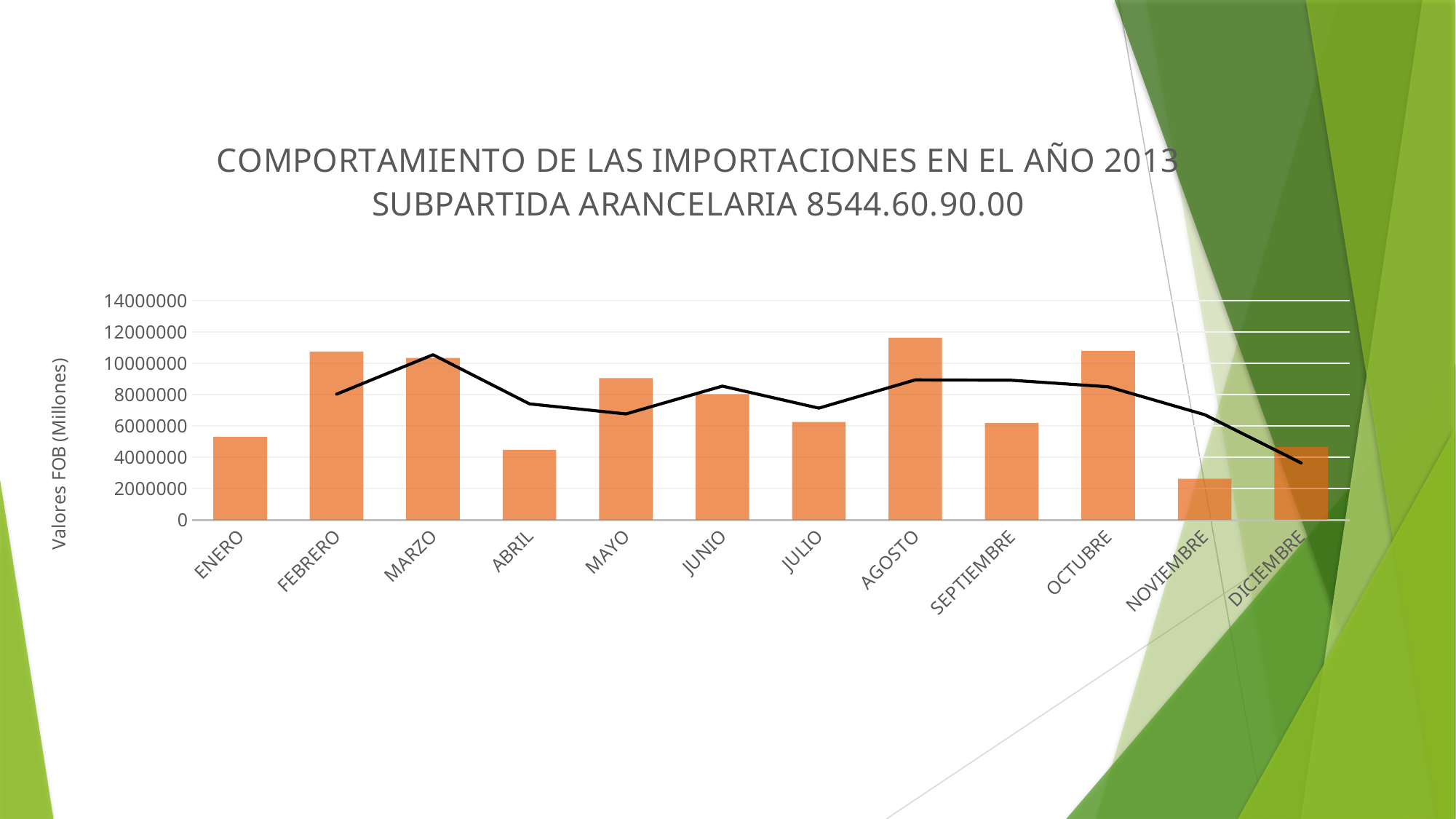
Is the value for MAYO greater or less than 8000000? greater Is the value for NOVIEMBRE greater or less than 4000000? less How many months (categories) are shown on the x axis? 12 Is the value for ENERO greater or less than 6000000? less What type of chart is shown on the slide? Bar chart with a trend line Which is larger, the bar for ABRIL or the bar for MAYO? MAYO What is the label of the vertical axis? Valores FOB (Millones) Which month has the highest bar? AGOSTO Which is larger, the bar for JUNIO or the bar for JULIO? JUNIO What subpartida arancelaria is named in the chart title? 8544.60.90.00 Which month has the lowest bar? NOVIEMBRE